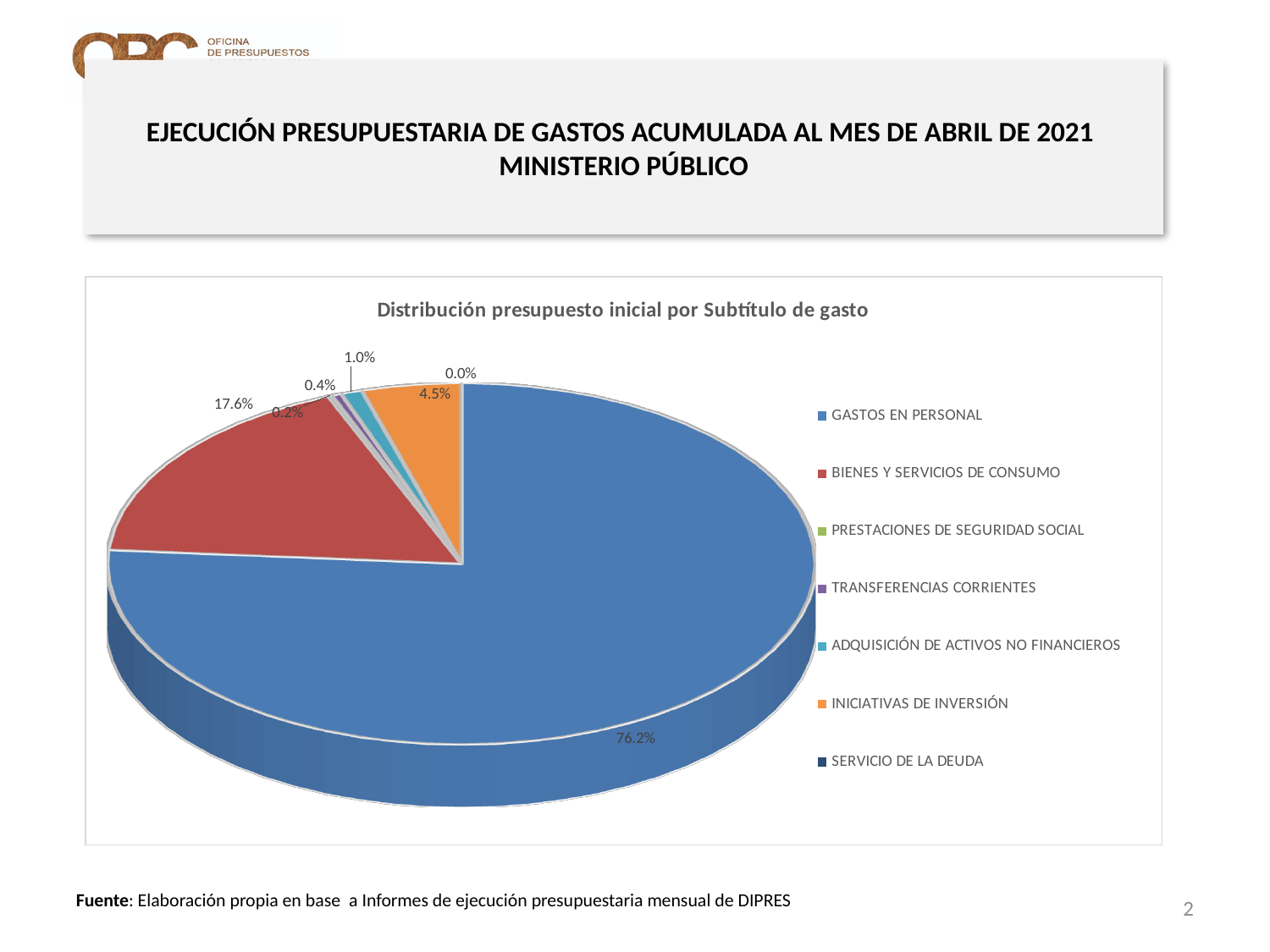
Which is larger, the share for BIENES Y SERVICIOS DE CONSUMO or the share for INICIATIVAS DE INVERSIÓN? BIENES Y SERVICIOS DE CONSUMO What percentage is shown for BIENES Y SERVICIOS DE CONSUMO? 17.6% What percentage is shown for INICIATIVAS DE INVERSIÓN? 4.5% What is the title of the chart? Distribución presupuesto inicial por Subtítulo de gasto What percentage is shown for SERVICIO DE LA DEUDA? 0.0% What is the difference in percentage points between GASTOS EN PERSONAL and BIENES Y SERVICIOS DE CONSUMO? 58.6 What percentage is shown for ADQUISICIÓN DE ACTIVOS NO FINANCIEROS? 1.0% How many categories does the legend list? 7 Which category has the largest share of the pie? GASTOS EN PERSONAL What share of the pie does GASTOS EN PERSONAL represent? 76.2% What kind of chart is shown on the slide? Pie chart Which category has the smallest share of the pie? SERVICIO DE LA DEUDA